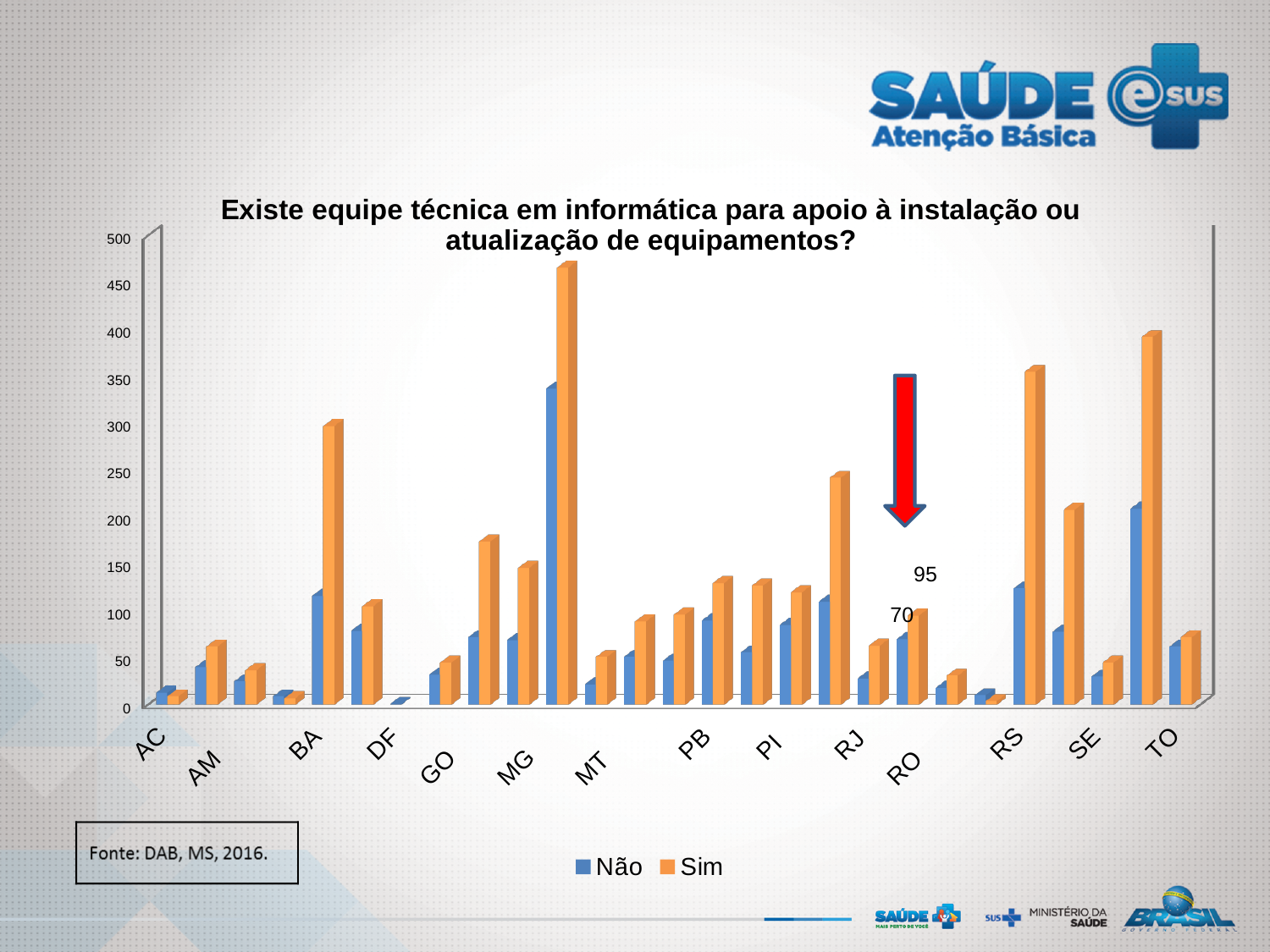
What is the source cited for the chart data? DAB, MS, 2016 Is the Sim value for TO greater or less than 350? less What type of chart is shown on the slide? bar chart Which state has the highest Sim value? MG What are the two series named in the legend? Não and Sim What value is printed on the orange (Sim) bar that the red arrow points to? 95 For the pair of bars marked by the red arrow, which is larger, Não or Sim? Sim For the pair of bars marked by the red arrow, what is the difference between the Sim value and the Não value? 25 Is the Não value for AC greater or less than 50? less How many series does the legend list? 2 What value is printed on the blue (Não) bar that the red arrow points to? 70 Is the Sim value for BA greater or less than 250? greater